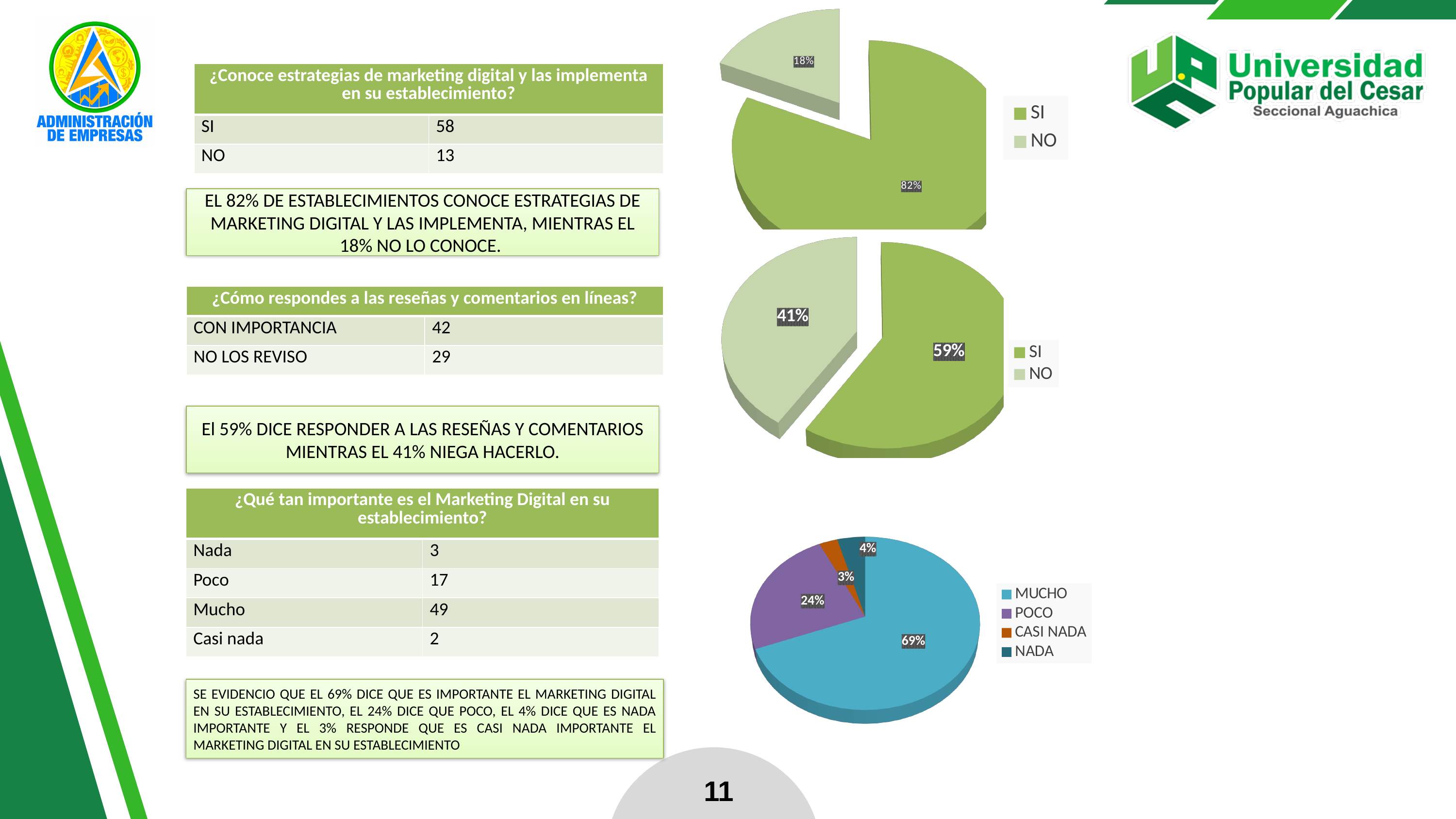
What type of chart is the bottom chart on the right? Pie chart In the top pie chart on the right, what is the difference in percentage points between the SI and NO slices? 64 In the bottom pie chart on the right, how many categories does the legend list? 4 In the middle pie chart on the right, which slice is larger, SI or NO? SI In the middle pie chart on the right, what percentage is shown for the NO slice? 41% In the bottom pie chart on the right, what is the difference in percentage points between POCO and NADA? 20 In the top pie chart on the right, what percentage is shown for the NO slice? 18% In the bottom pie chart on the right, which category has the smallest slice? CASI NADA In the top pie chart on the right, what percentage is shown for the SI slice? 82% In the middle pie chart on the right, how many entries does the legend list? 2 In the bottom pie chart on the right, what percentage is shown for MUCHO? 69% In the bottom pie chart on the right, what percentage is shown for CASI NADA? 3%